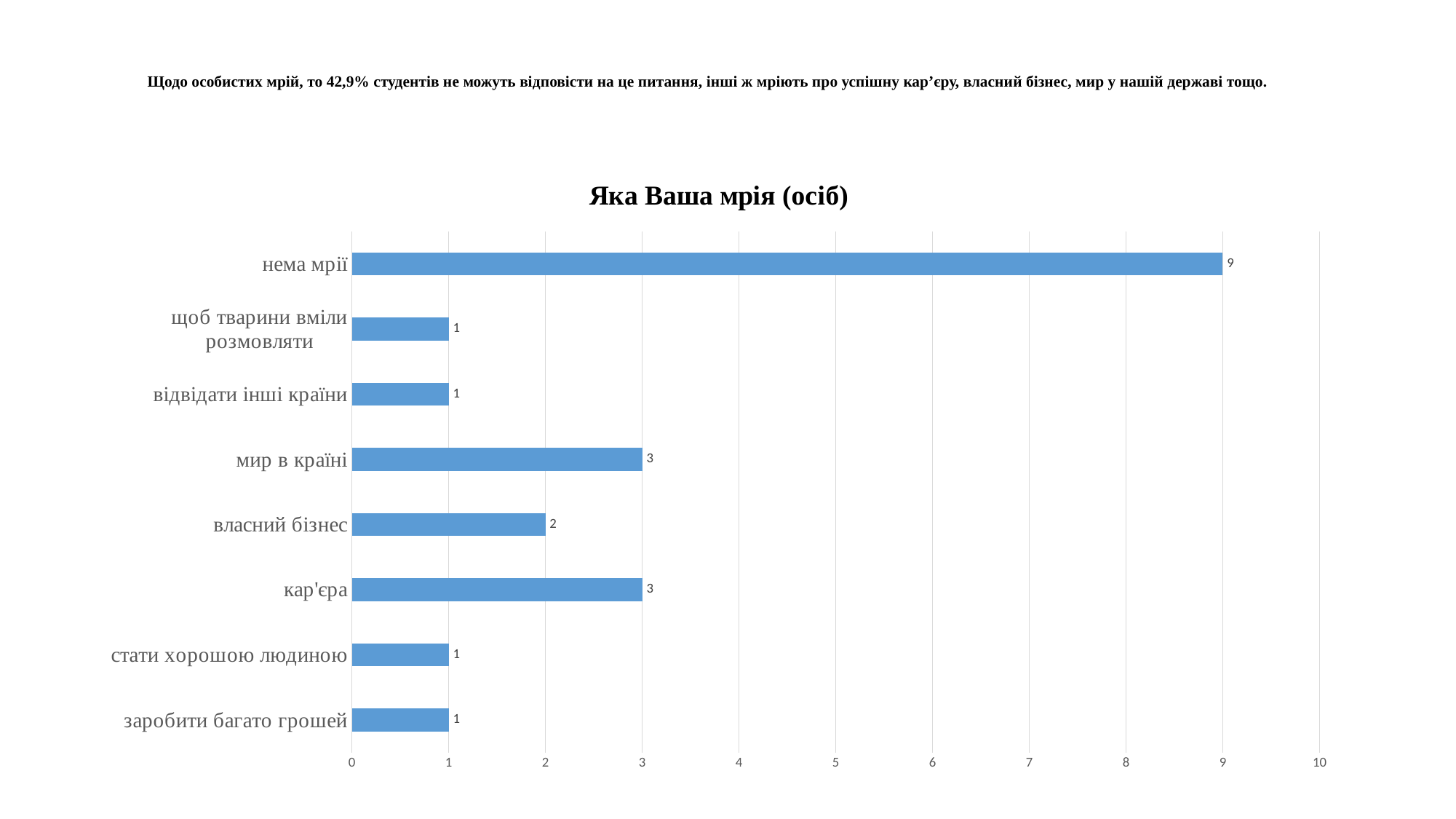
What is the value for "власний бізнес"? 2 What is the difference between the values for "нема мрії" and "кар'єра"? 6 How many categories are shown in the chart? 8 Is the value for "нема мрії" greater or less than 5? greater What is the value for "нема мрії"? 9 What is the value for "мир в країні"? 3 What kind of chart is shown on the slide? bar chart Which category has the highest value? нема мрії What is the title of the chart? Яка Ваша мрія (осіб) What is the difference between the values for "мир в країні" and "власний бізнес"? 1 Which is larger, the value for "власний бізнес" or the value for "відвідати інші країни"? власний бізнес What is the value for "кар'єра"? 3